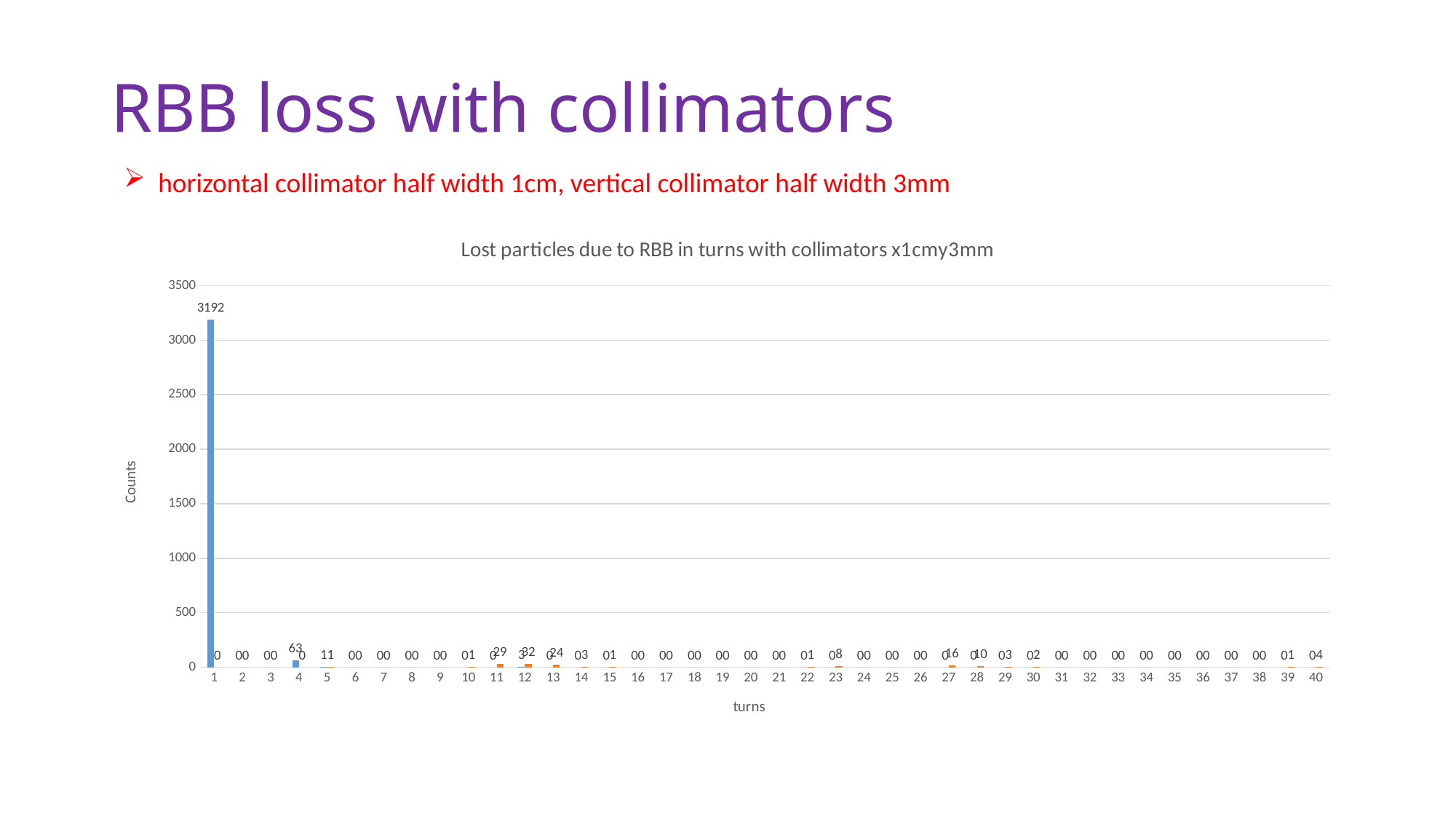
What is the highest tick value shown on the vertical axis? 3500 Is the value of the bar at turn 1 greater or less than 3000? greater What is the value of the blue bar at turn 4? 63 What is the title of the chart? Lost particles due to RBB in turns with collimators x1cmy3mm Which turn has the highest count in the chart? 1 What is the label of the vertical axis of the chart? Counts What is the value of the tallest bar at turn 1? 3192 Which is larger, the count at turn 1 or the count at turn 4? turn 1 How many turns are shown along the x axis of the chart? 40 What kind of chart is shown on the slide? bar chart Is the value of the blue bar at turn 4 greater or less than 500? less What is the difference between the blue bar at turn 1 (3192) and the blue bar at turn 4 (63)? 3129